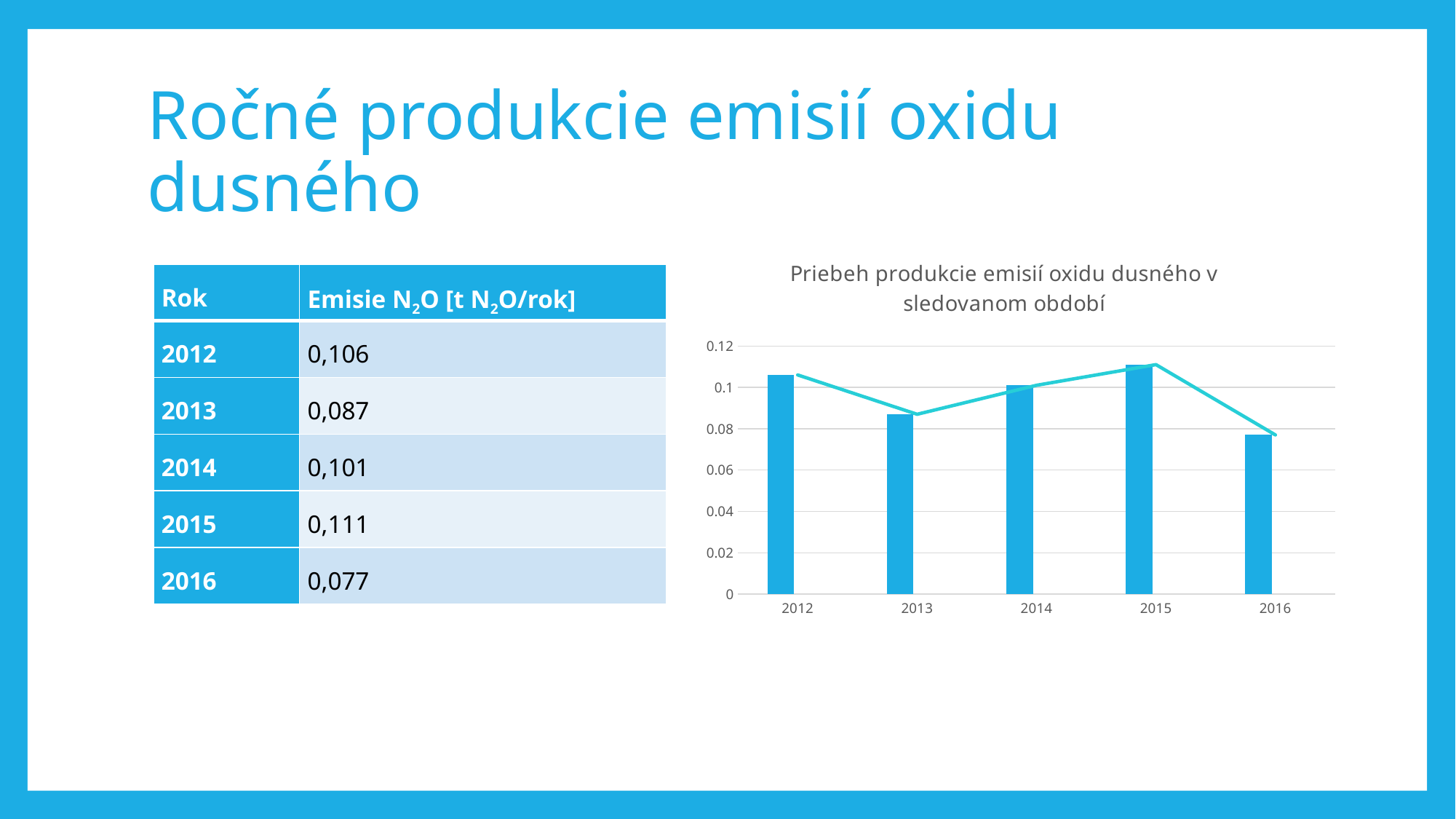
What is the N2O emission value for 2014 as printed on the slide? 0,101 Which year has the highest N2O emissions in the chart? 2015 How many years are plotted on the x axis of the chart? 5 What is the title of the chart? Priebeh produkcie emisií oxidu dusného v sledovanom období What kind of chart is shown on the slide? combination bar and line chart Is the value for 2015 greater or less than 0.1? greater Is the value for 2013 greater or less than 0.1? less Which is larger, the value for 2012 or the value for 2013? 2012 Do the values rise or fall from 2013 to 2015? rise What is the difference between the 2015 and 2016 values printed on the slide? 0,034 Is the value for 2016 greater or less than 0.08? less Which year has the lowest N2O emissions in the chart? 2016